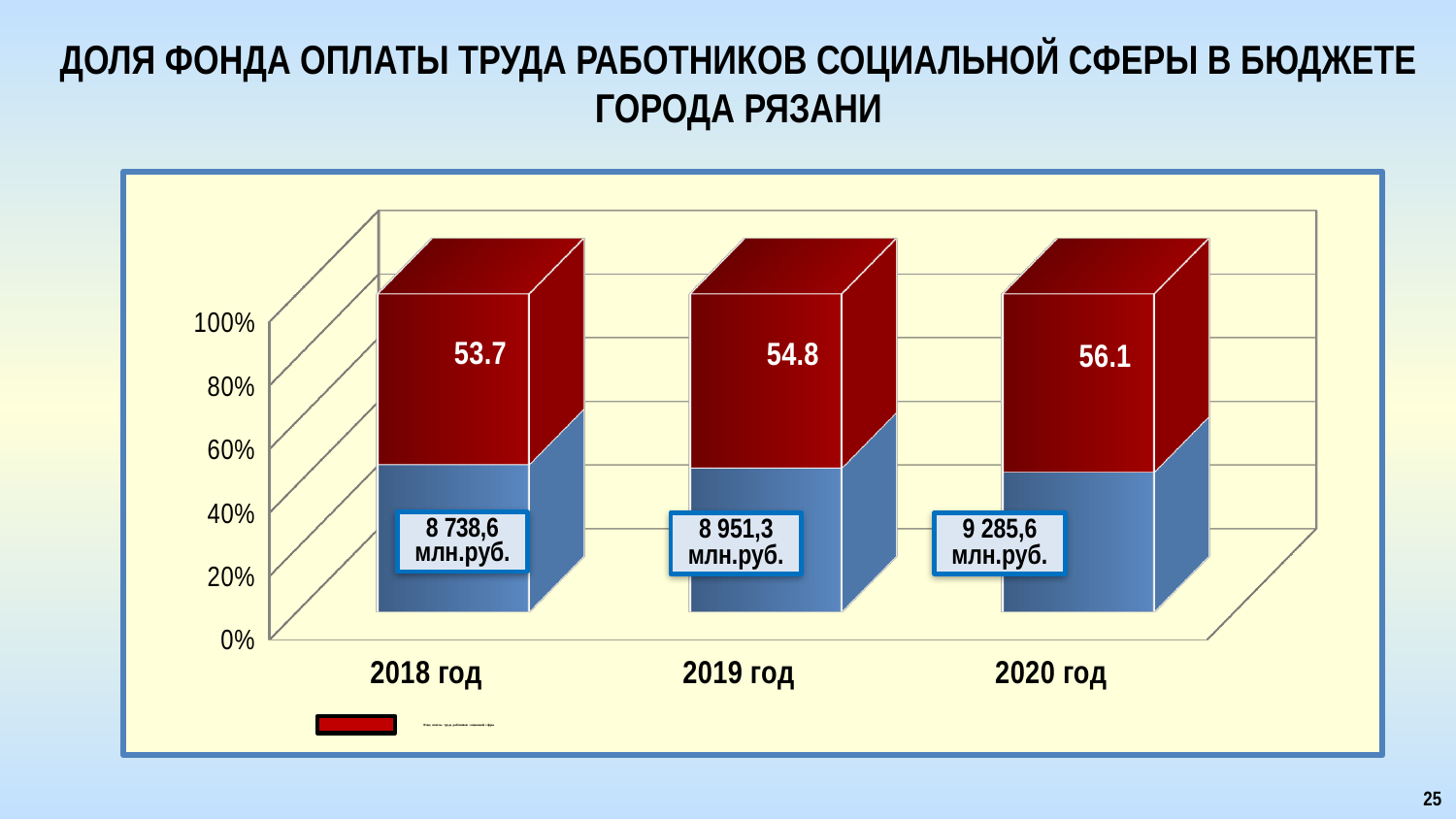
What is the difference between the red-segment values for 2020 год and 2018 год? 2.4 Which year has the lowest value printed on its red segment? 2018 год Which year has the highest value printed on its red segment? 2020 год What is the difference between the red-segment values for 2019 год and 2018 год? 1.1 How many years are shown on the x axis of the chart? 3 Which is larger, the red-segment value for 2019 год or for 2020 год? 2020 год What value is printed on the red segment of the bar for 2018 год? 53.7 What amount in млн.руб. is shown on the bar for 2019 год? 8 951,3 млн.руб. What kind of chart is shown on the slide? Stacked bar chart What amount in млн.руб. is shown on the bar for 2020 год? 9 285,6 млн.руб. What value is printed on the red segment of the bar for 2020 год? 56.1 Do the red-segment values rise or fall from 2018 год to 2020 год? Rise